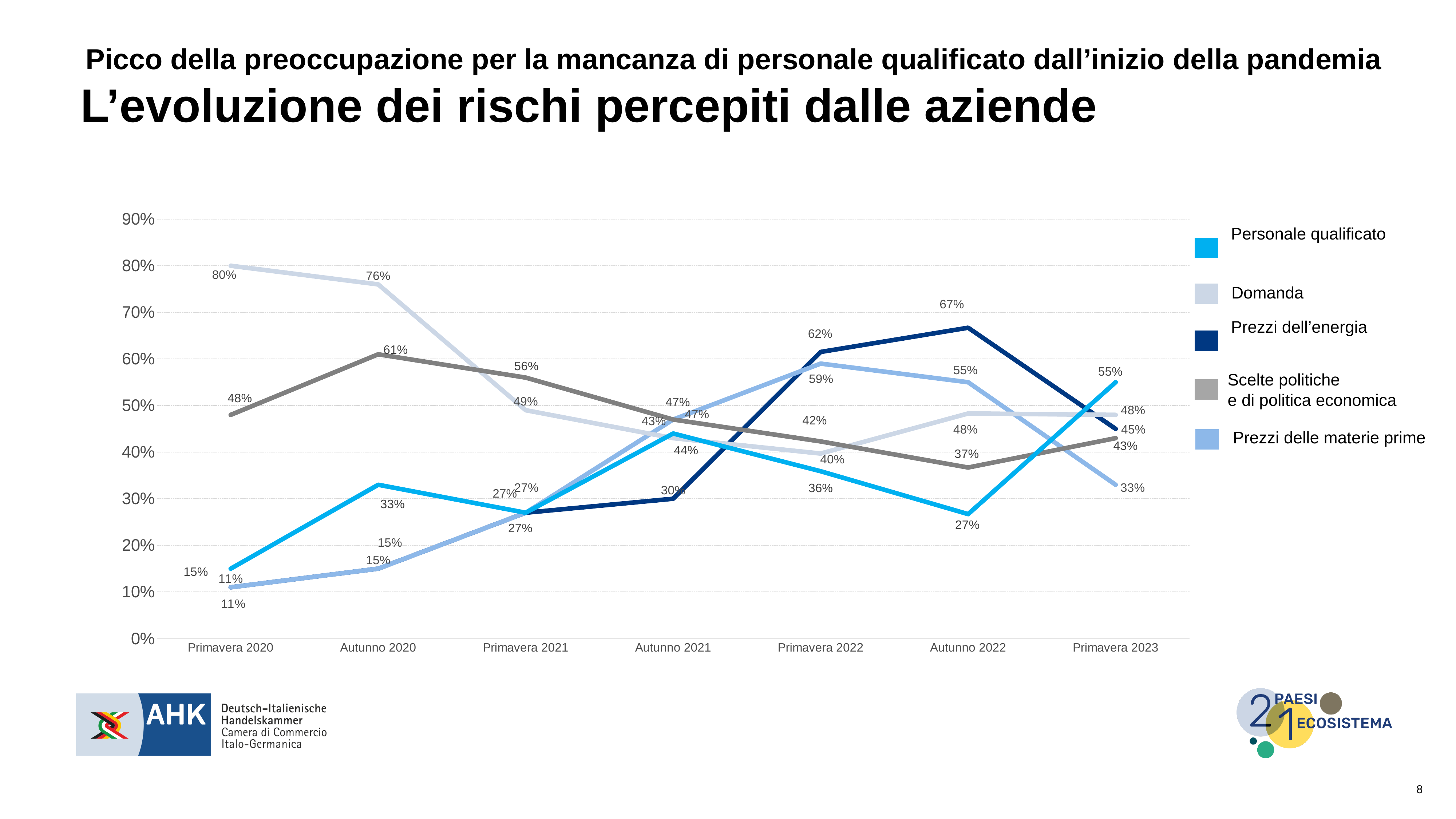
What is the value for Prezzi delle materie prime in Primavera 2022? 59% What kind of chart is shown on the slide? Line chart In which period is Personale qualificato at its lowest value? Primavera 2020 In Primavera 2022, which is higher: Prezzi dell'energia or Personale qualificato? Prezzi dell'energia In which period does Prezzi dell'energia reach its highest value? Autunno 2022 How many time periods are shown on the x axis? 7 What is the value for Personale qualificato in Primavera 2023? 55% What is the difference between the Domanda values in Primavera 2020 and Autunno 2020? 4 percentage points What is the value for Domanda in Primavera 2020? 80% How many series does the legend list? 5 What is the value for Scelte politiche e di politica economica in Autunno 2020? 61% What is the value for Prezzi dell'energia in Autunno 2022? 67%